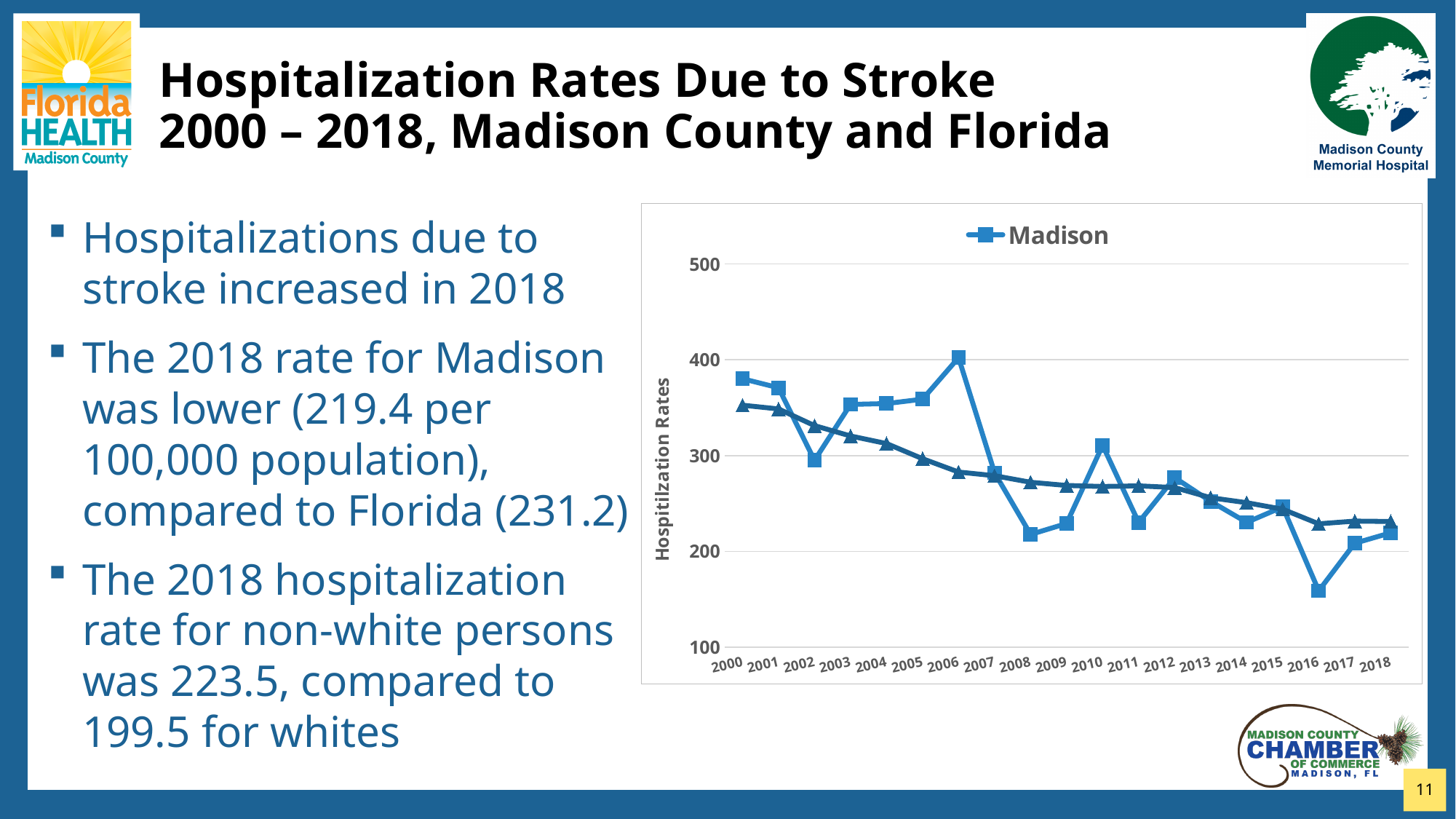
Is the Madison value for 2016 greater or less than 200? less Is the Madison value for 2000 greater or less than 350? greater In which year does the Madison series reach its lowest value? 2016 Is the Madison value for 2008 greater or less than 300? less How many series does the chart's legend list? 1 How many years are plotted along the x axis of the chart? 19 Overall, do the Madison values rise or fall from 2000 to 2018? fall What kind of chart is shown on the slide? line chart What is the label on the chart's vertical axis? Hospitilzation Rates Which year has the higher Madison value, 2000 or 2008? 2000 Which series name appears in the chart's legend? Madison In which year does the Madison series reach its highest value? 2006